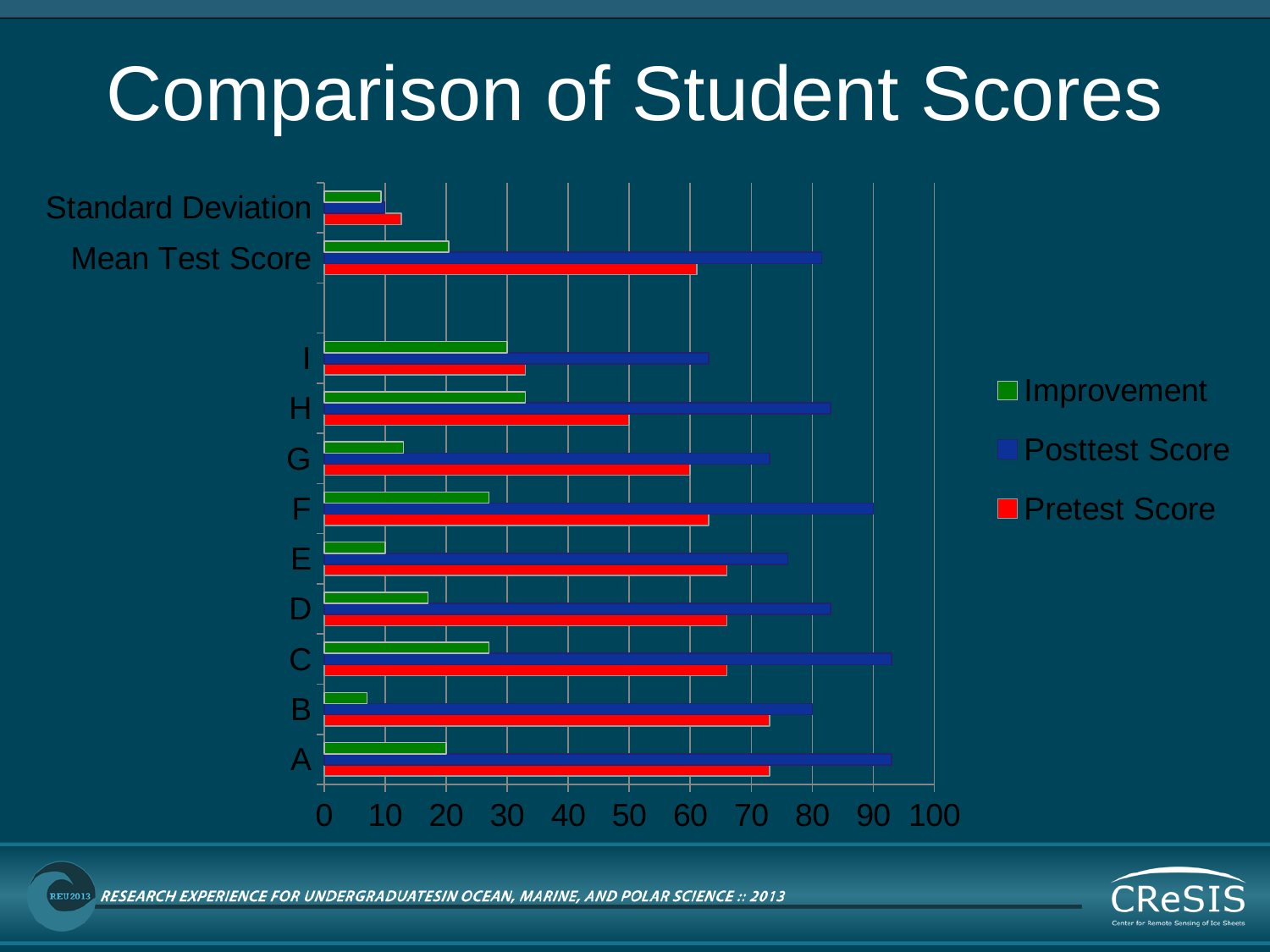
What kind of chart is shown on the slide? bar chart How many series does the legend list? 3 What are the three series named in the legend? Improvement, Posttest Score, Pretest Score Which student has the lowest Posttest Score? I How many lettered student categories (A through I) are plotted? 9 Which student has the lowest Pretest Score? I Is the Posttest Score for F greater or less than 80? greater Which is larger for student C: the Improvement value or the Improvement value for student G? C Which student has the lowest Improvement value? B Is the Pretest Score for H greater or less than 60? less Is the Improvement value for B greater or less than 10? less